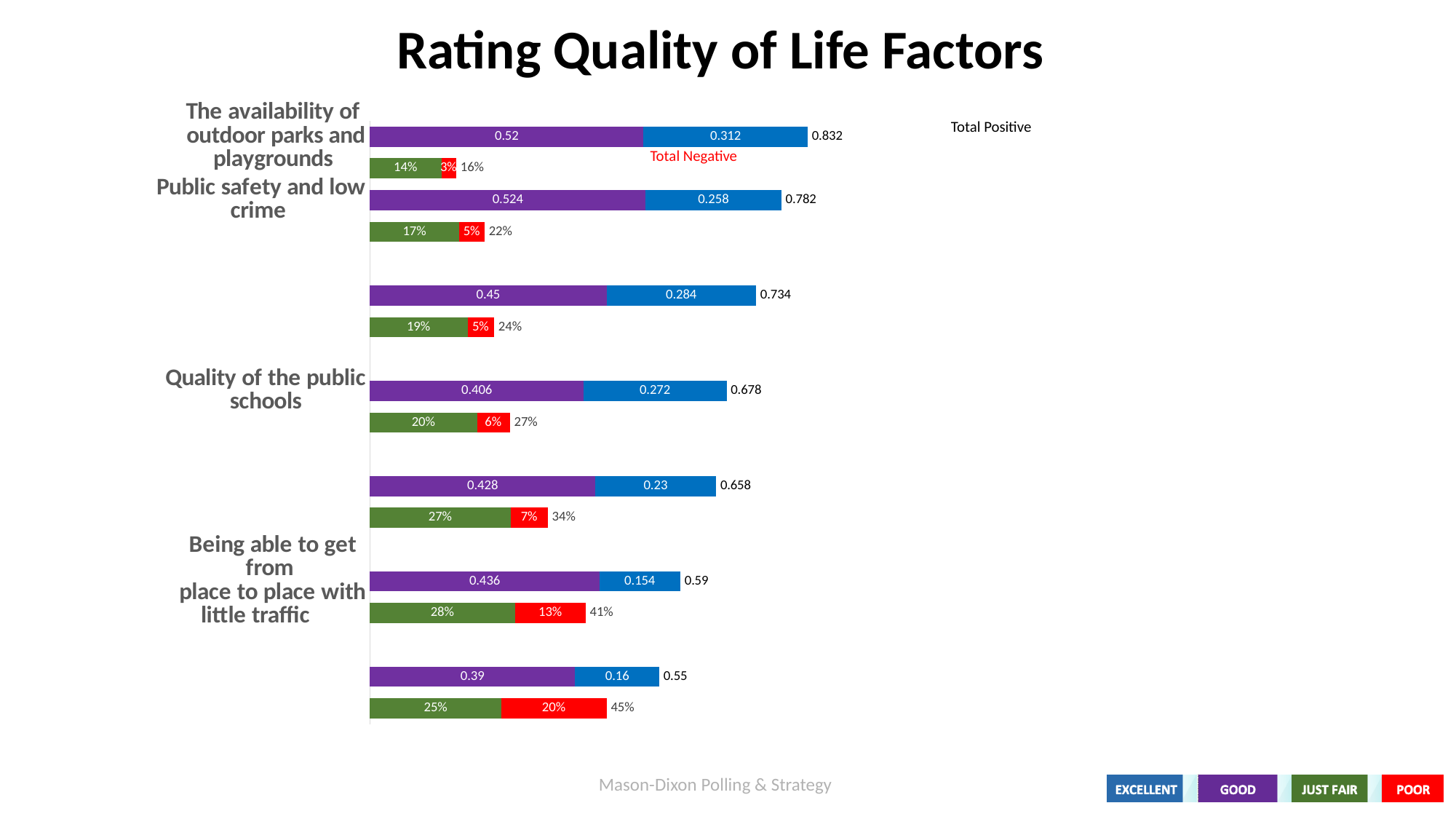
What colour represents POOR in the legend? Red What is the highest Total Negative value shown on the chart? 45% What kind of chart is shown on the slide? Bar chart What is the difference between the EXCELLENT values for 'The availability of outdoor parks and playgrounds' (0.312) and 'Public safety and low crime' (0.258)? 0.054 What is the lowest Total Positive value shown on the chart? 0.55 What is the JUST FAIR value for 'Quality of the public schools'? 20% How many series does the legend list? 4 What is the GOOD value for 'Public safety and low crime'? 0.524 What is the Total Negative value for 'The availability of outdoor parks and playgrounds'? 16% What is the Total Positive value for 'The availability of outdoor parks and playgrounds'? 0.832 Which has a larger POOR value: 'Quality of the public schools' or 'Being able to get from place to place with little traffic'? Being able to get from place to place with little traffic Which factor has the highest Total Positive value? The availability of outdoor parks and playgrounds